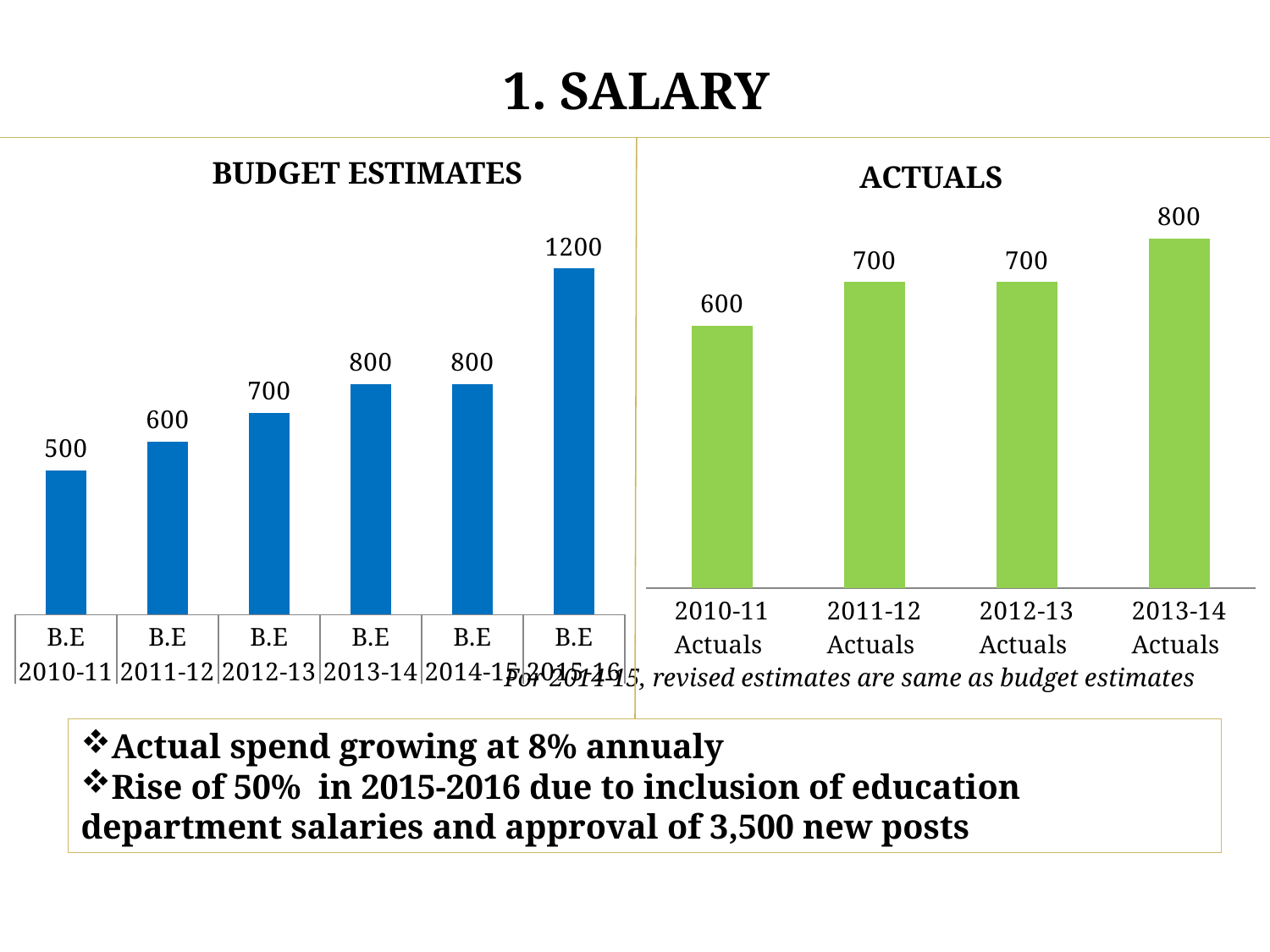
In the BUDGET ESTIMATES chart, what is the value for B.E 2015-16? 1200 In the ACTUALS chart, what is the difference between 2013-14 Actuals and 2010-11 Actuals? 200 What type of chart is the ACTUALS chart? Bar chart In the ACTUALS chart, what is the value for 2013-14 Actuals? 800 In the ACTUALS chart, which category has the lowest value? 2010-11 Actuals In the BUDGET ESTIMATES chart, what is the value for B.E 2010-11? 500 In the ACTUALS chart, what is the value for 2010-11 Actuals? 600 In the BUDGET ESTIMATES chart, what is the difference between B.E 2015-16 and B.E 2014-15? 400 How many bars are in the ACTUALS chart? 4 In the BUDGET ESTIMATES chart, which is larger, B.E 2012-13 or B.E 2013-14? B.E 2013-14 In the BUDGET ESTIMATES chart, which category has the highest value? B.E 2015-16 How many bars are in the BUDGET ESTIMATES chart? 6